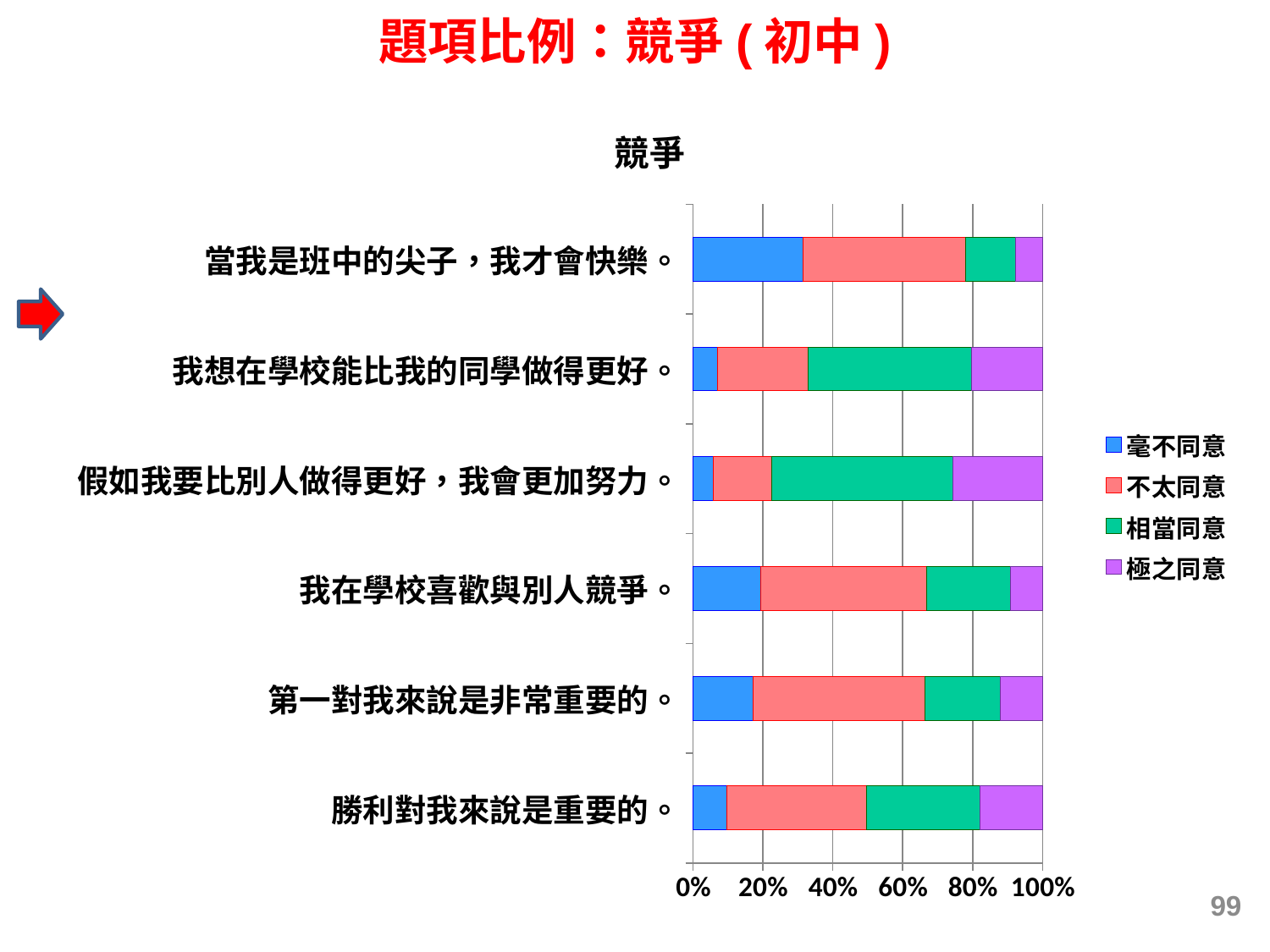
Which statement has the largest 毫不同意 share? 當我是班中的尖子，我才會快樂。 What kind of chart is shown on the slide? stacked bar chart What are the four legend entries in the 競爭 chart? 毫不同意, 不太同意, 相當同意, 極之同意 Is the 毫不同意 share for 「我想在學校能比我的同學做得更好。」 greater or less than 20%? less How many statements (categories) are plotted in the 競爭 chart? 6 Which has the larger 毫不同意 share: 「當我是班中的尖子，我才會快樂。」 or 「勝利對我來說是重要的。」? 當我是班中的尖子，我才會快樂。 Which has the larger 相當同意 share: 「假如我要比別人做得更好，我會更加努力。」 or 「當我是班中的尖子，我才會快樂。」? 假如我要比別人做得更好，我會更加努力。 What is the title shown above the chart? 競爭 Is the 毫不同意 share for 「當我是班中的尖子，我才會快樂。」 greater or less than 20%? greater Is the 毫不同意 share for 「假如我要比別人做得更好，我會更加努力。」 greater or less than 20%? less How many series does the legend of the 競爭 chart list? 4